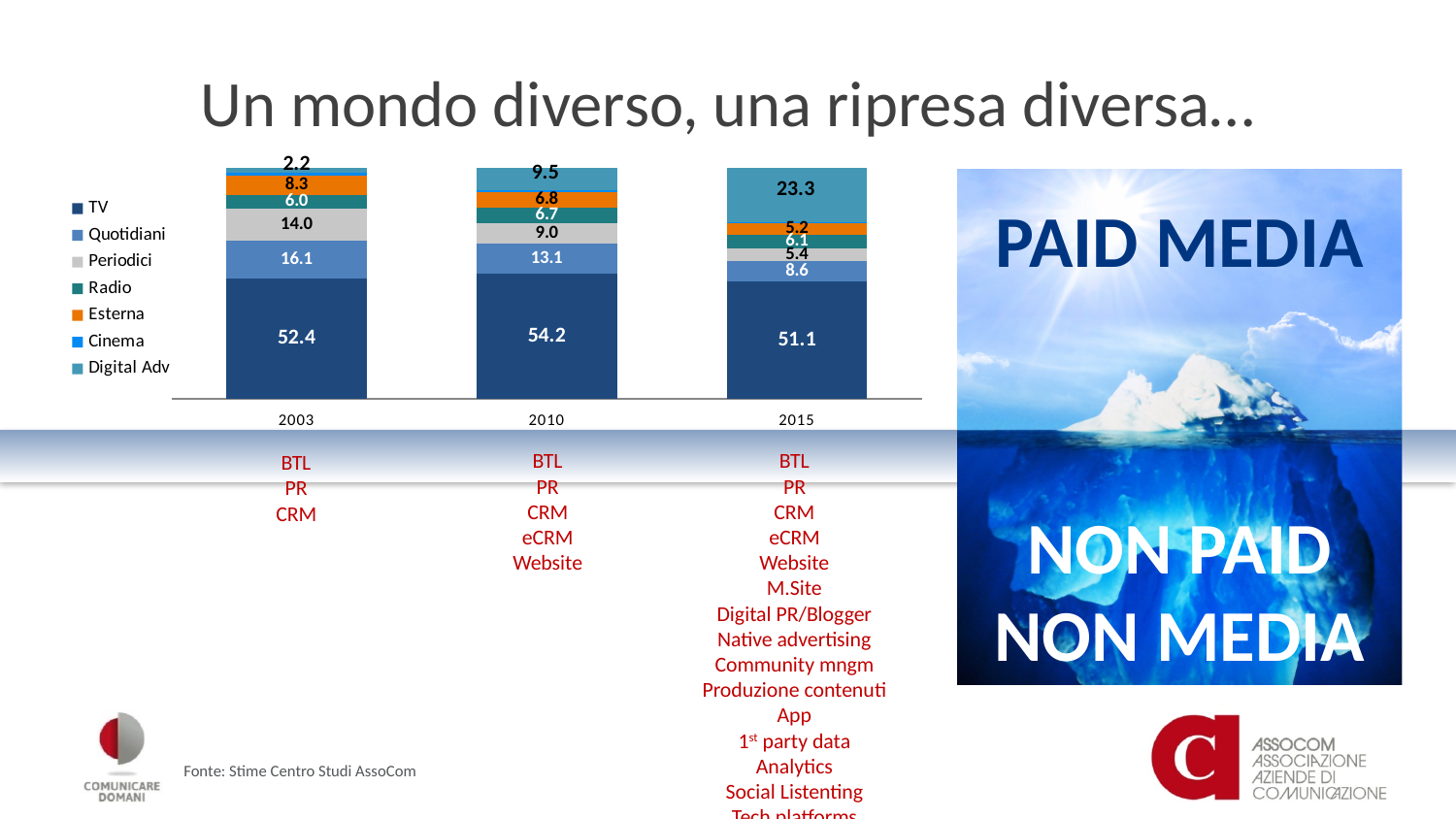
What is the value of the Digital Adv segment for 2015? 23.3 In which year is the TV segment the largest? 2010 How many series does the legend list? 7 What kind of chart is shown on the slide? Stacked bar chart Which is larger, the Periodici value in 2003 or in 2010? 2003 What is the difference between the TV value in 2010 and in 2015? 3.1 What is the difference between the Quotidiani value in 2003 and in 2015? 7.5 What is the value of the Periodici segment for 2010? 9.0 What is the value of the Quotidiani segment for 2003? 16.1 How many years (bars) are shown in the chart? 3 In which year is the Digital Adv segment the smallest? 2003 What is the value of the TV segment for 2015? 51.1